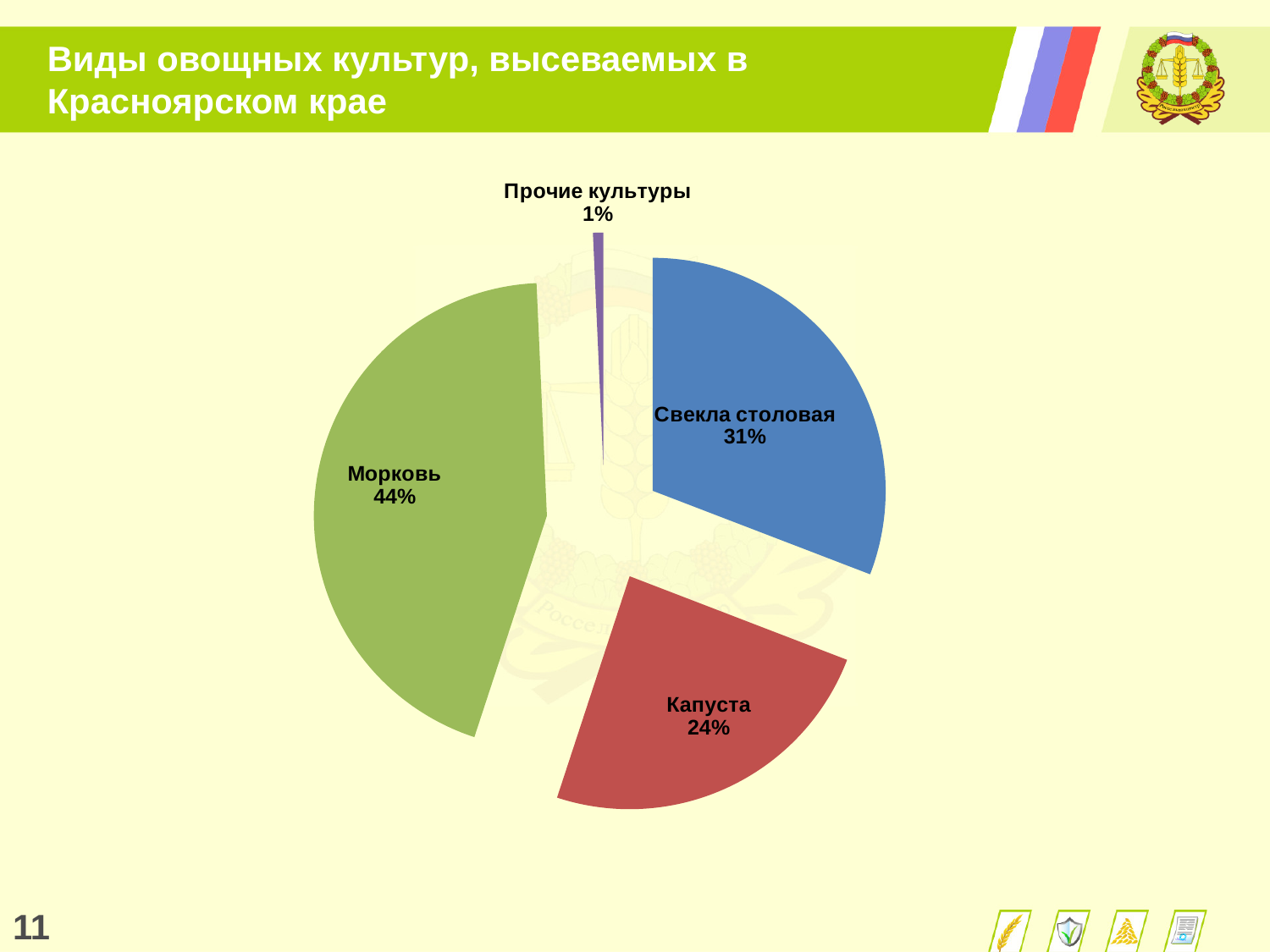
What is the value shown for Капуста? 24% How many categories are shown in the pie chart? 4 What share of the pie does Морковь have? 44% What is the value shown for Прочие культуры? 1% What kind of chart is shown on the slide? Pie chart What is the difference in percentage points between Свекла столовая and Капуста? 7 What is the value shown for Свекла столовая? 31% What is the difference in percentage points between Морковь and Капуста? 20 What colour is the slice for Капуста? Red Which category has the largest slice of the pie? Морковь Which is larger, the slice for Свекла столовая or the slice for Капуста? Свекла столовая Which category has the smallest slice of the pie? Прочие культуры